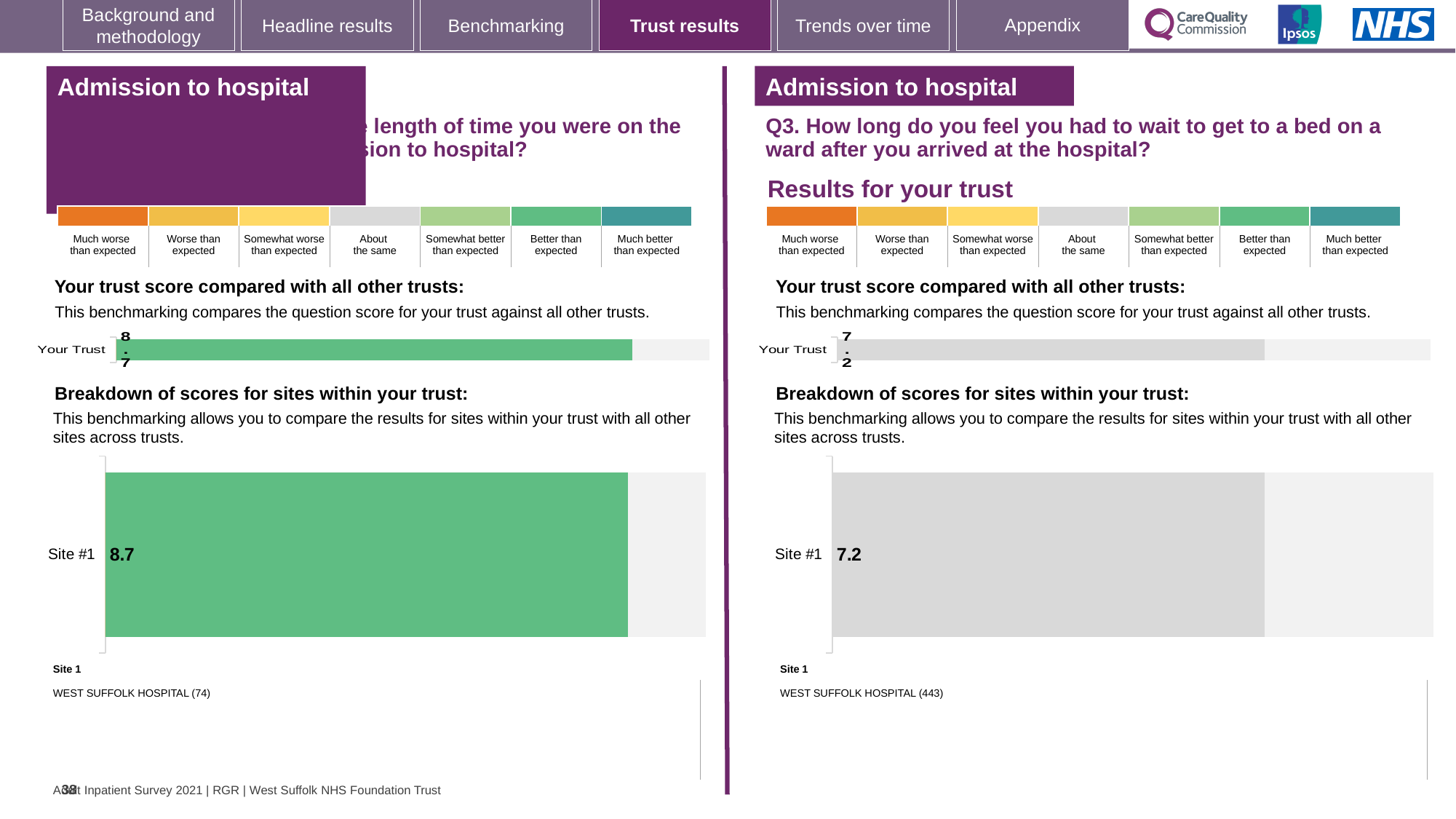
On the right-hand side of the slide (Q3), what is the score shown for Site #1? 7.2 What kind of chart is used to show the Site #1 score on the right-hand side of the slide (Q3)? Bar chart Which is larger: the Site #1 score on the left-hand chart or the Site #1 score on the right-hand chart (Q3)? Left-hand chart (8.7) According to the colour key, which benchmark category does the grey colour of the Site #1 bar on the right-hand chart (Q3) represent? About the same On the left-hand side of the slide, what is the score shown for Site #1? 8.7 On the left-hand side of the slide, what is the score shown for 'Your Trust'? 8.7 How many sites are shown in the 'Breakdown of scores for sites within your trust' chart on the right-hand side (Q3)? 1 What is the difference between the Site #1 score on the left-hand chart (8.7) and the Site #1 score on the right-hand chart (7.2)? 1.5 How many sites are shown in the 'Breakdown of scores for sites within your trust' chart on the left-hand side? 1 Which site name is listed under 'Site 1' on the right-hand side of the slide (Q3)? WEST SUFFOLK HOSPITAL (443) On the right-hand side of the slide (Q3), what is the score shown for 'Your Trust'? 7.2